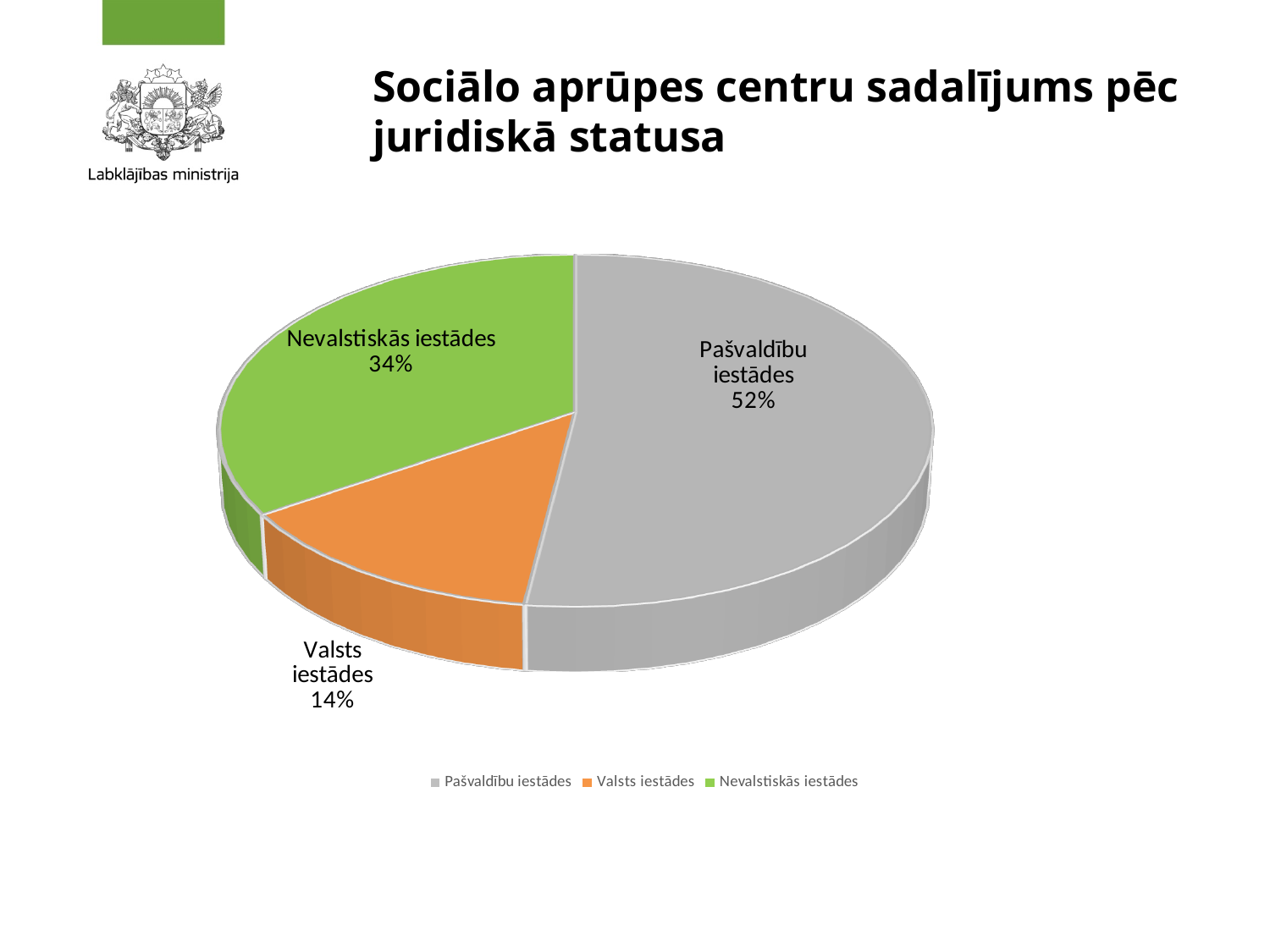
What is the title of the chart on the slide? Sociālo aprūpes centru sadalījums pēc juridiskā statusa Which category has the largest share of the pie? Pašvaldību iestādes What colour is the slice for Valsts iestādes? Orange How many categories are shown in the pie chart? 3 What is the difference in percentage points between Nevalstiskās iestādes and Valsts iestādes? 20 Which category has the smallest share of the pie? Valsts iestādes What share of the pie does Valsts iestādes hold? 14% What share of the pie does Nevalstiskās iestādes hold? 34% What is the difference in percentage points between Pašvaldību iestādes and Nevalstiskās iestādes? 18 What kind of chart is shown on the slide? Pie chart What share of the pie does Pašvaldību iestādes hold? 52% Which is larger, the share for Nevalstiskās iestādes or the share for Valsts iestādes? Nevalstiskās iestādes